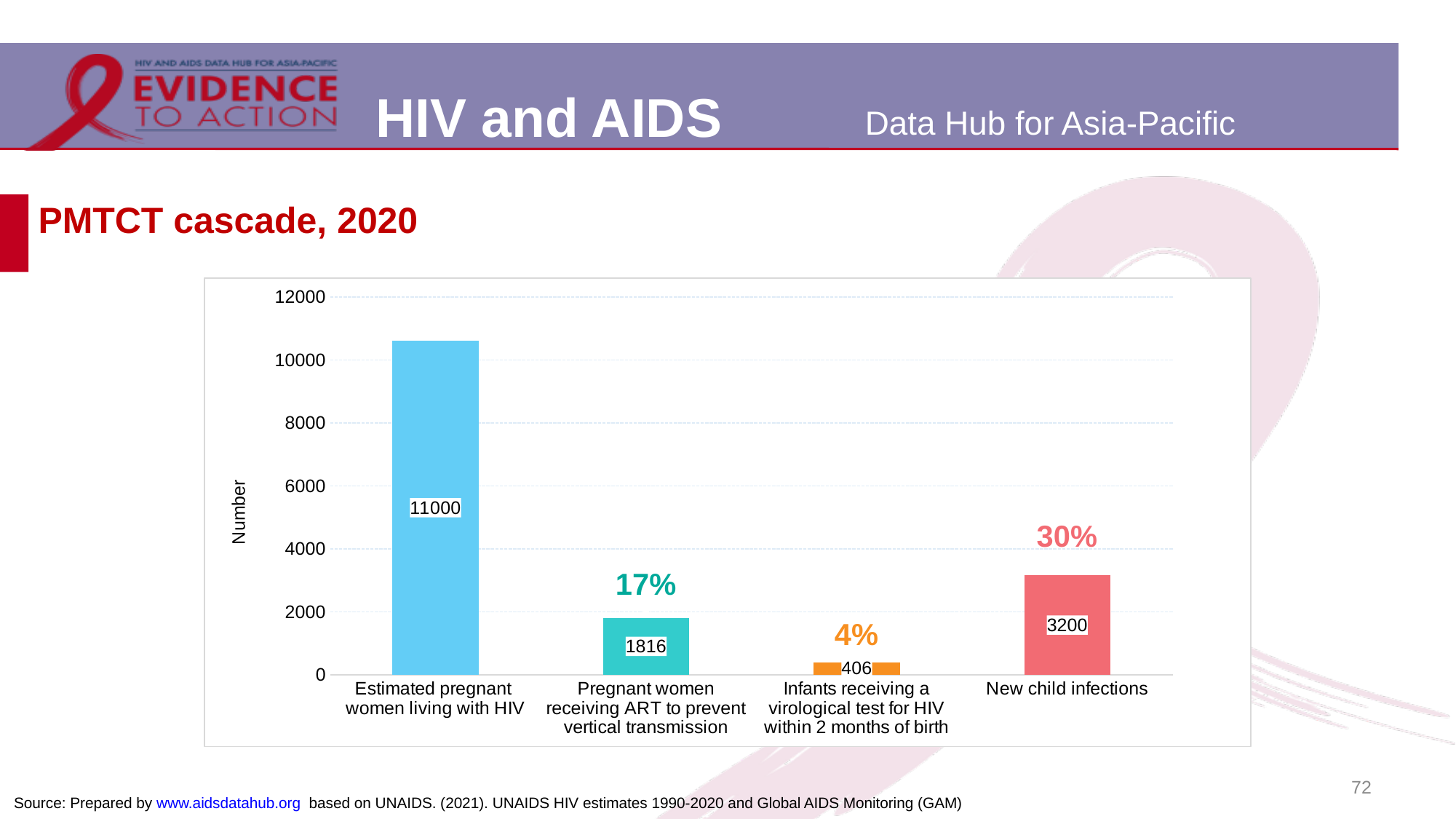
What is the value for Infants receiving a virological test for HIV within 2 months of birth? 406 Which is larger: the value for Pregnant women receiving ART to prevent vertical transmission or the value for New child infections? New child infections Which category has the highest value? Estimated pregnant women living with HIV What is the difference between the values for Estimated pregnant women living with HIV and New child infections? 7800 What is the title of the chart? PMTCT cascade, 2020 What kind of chart is shown on the slide? Bar chart What is the value for New child infections? 3200 Which category has the lowest value? Infants receiving a virological test for HIV within 2 months of birth What is the value for Estimated pregnant women living with HIV? 11000 How many categories are shown on the x axis? 4 What is the value for Pregnant women receiving ART to prevent vertical transmission? 1816 What percentage label is shown above the bar for Pregnant women receiving ART to prevent vertical transmission? 17%